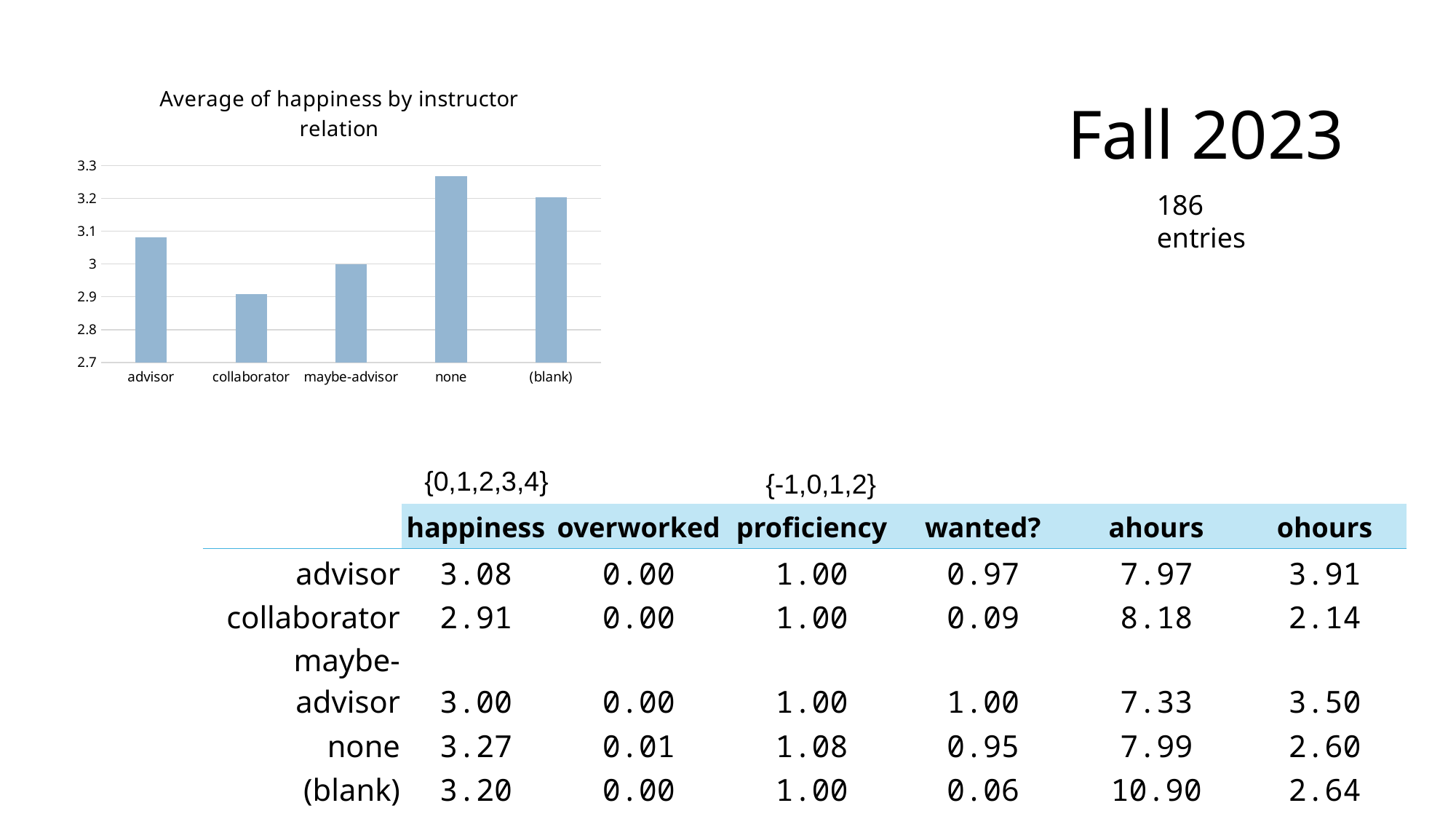
Which instructor relation has the lowest average happiness in the chart? collaborator What is the title of the chart? Average of happiness by instructor relation Which instructor relation has the highest average happiness in the chart? none How many categories are shown on the x axis of the chart? 5 What is the average happiness for maybe-advisor in the chart? 3 According to the table on the slide, what is the happiness value for none? 3.27 Is the average happiness for collaborator greater or less than 3? less Which has a higher average happiness in the chart, advisor or (blank)? (blank) Is the average happiness for none greater or less than 3.2? greater What kind of chart is shown on the slide? bar chart Using the happiness values in the table, what is the difference between none and collaborator? 0.36 Is the average happiness for advisor greater or less than 3? greater